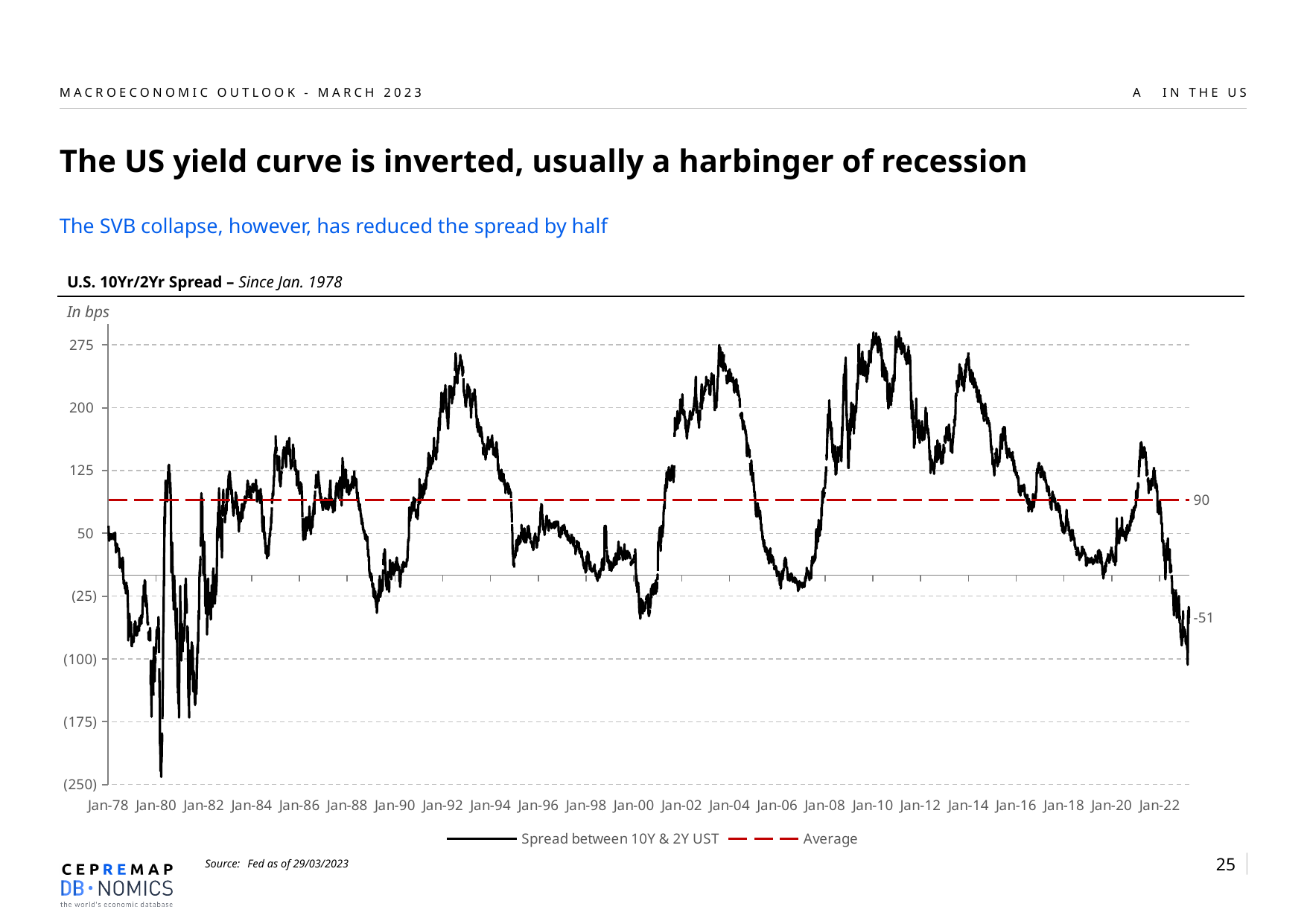
What is the title of the chart? U.S. 10Yr/2Yr Spread – Since Jan. 1978 How many date labels are shown on the x axis? 23 Is the lowest value of the spread around Jan-80 greater or less than (175)? less What kind of chart is shown on the slide? line chart Is the peak value of the spread around Jan-92 greater or less than 200? greater Which is larger, the Average value or the latest spread value? Average What is the latest value of the spread between 10Y & 2Y UST labelled at the right end of the chart? -51 In what unit are the values on the chart expressed? bps What is the value of the Average line shown on the chart? 90 Between Jan-10 and Jan-18, does the spread generally rise or fall? fall How many series does the legend list? 2 What is the difference between the Average (90) and the latest spread value (-51)? 141